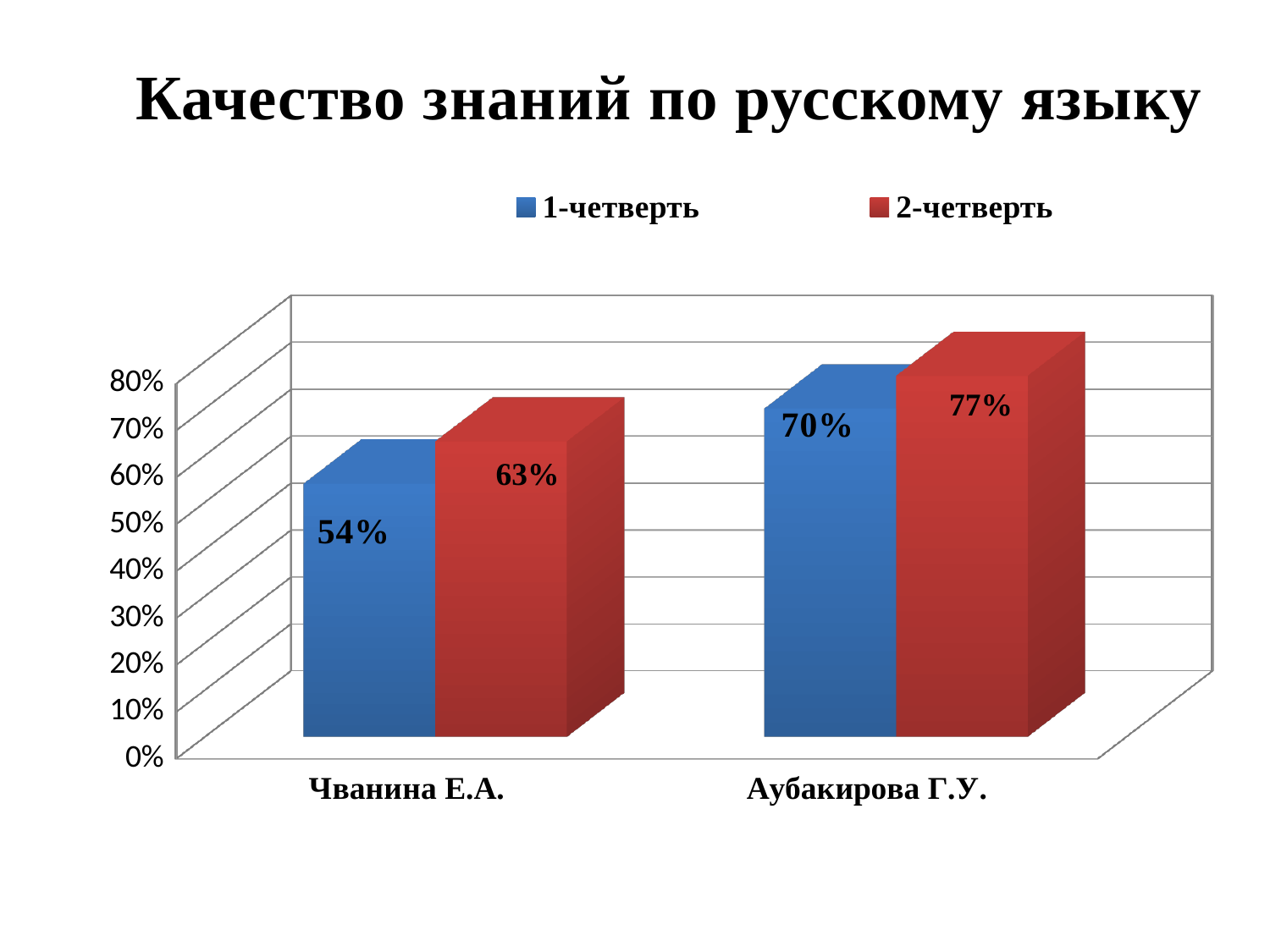
What is the value for Аубакирова Г.У. in the 1-четверть series? 70% What is the difference between the 1-четверть values for Аубакирова Г.У. and Чванина Е.А.? 16% What is the value for Аубакирова Г.У. in the 2-четверть series? 77% How many categories are shown on the x axis? 2 Which is larger: the 2-четверть value for Чванина Е.А. or the 1-четверть value for Аубакирова Г.У.? 1-четверть value for Аубакирова Г.У. Which category has the lowest value in the 1-четверть series? Чванина Е.А. What kind of chart is shown on the slide? Bar chart Which category has the highest value in the 2-четверть series? Аубакирова Г.У. How many series does the legend list? 2 What is the value for Чванина Е.А. in the 2-четверть series? 63% What is the difference between the 2-четверть and 1-четверть values for Чванина Е.А.? 9% What is the value for Чванина Е.А. in the 1-четверть series? 54%